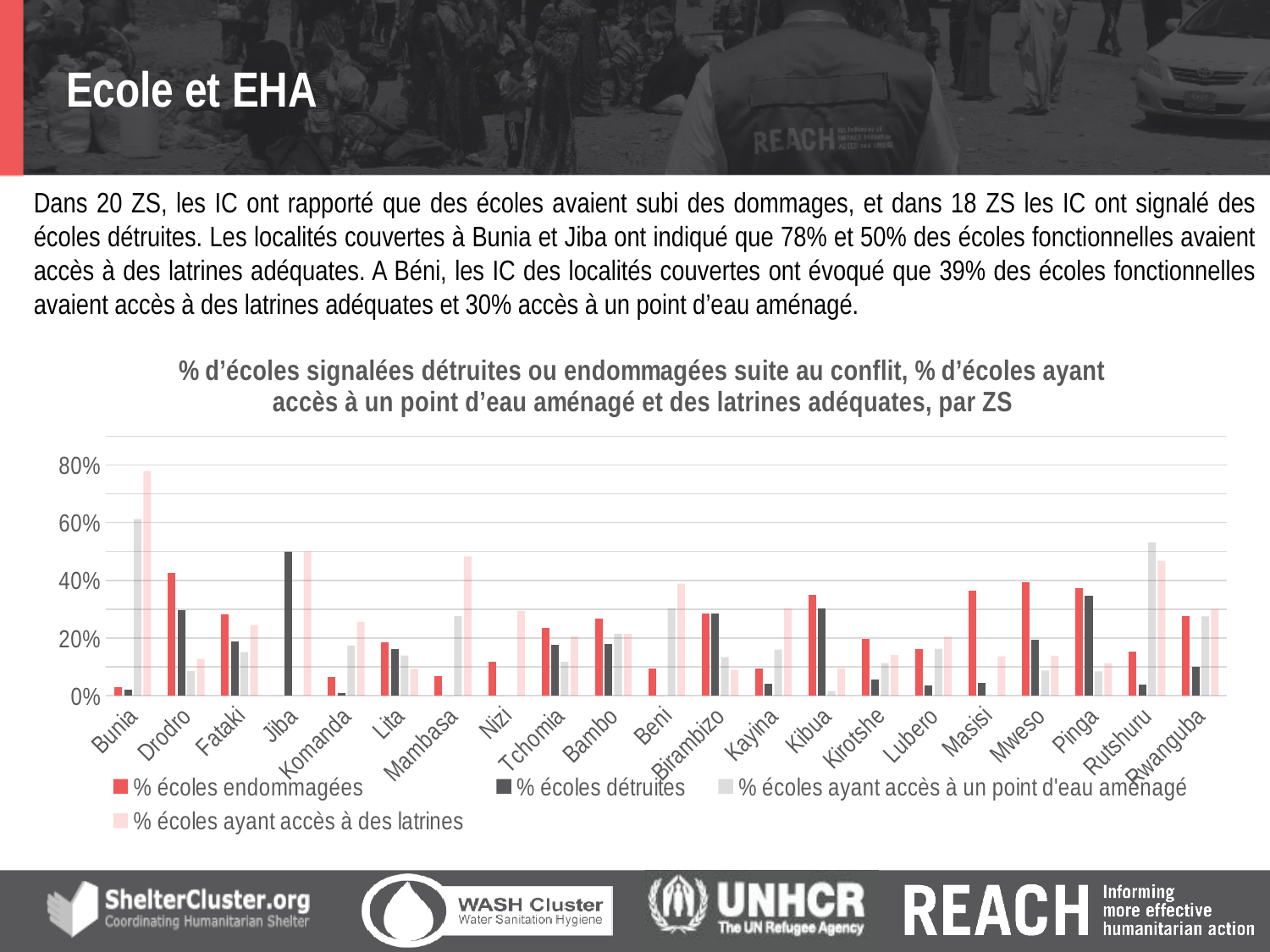
Which ZS has the highest value for % écoles détruites? Jiba Is the value for % écoles détruites in Jiba greater or less than 40%? greater Which ZS has the highest value for % écoles ayant accès à des latrines? Bunia Is the value for % écoles ayant accès à un point d'eau aménagé in Rutshuru greater or less than 40%? greater Which is larger: % écoles endommagées in Kibua or % écoles endommagées in Kayina? Kibua Which ZS has the highest value for % écoles ayant accès à un point d'eau aménagé? Bunia How many series does the chart legend list? 4 Is the value for % écoles ayant accès à des latrines in Bunia greater or less than 60%? greater What kind of chart is shown on the slide? bar chart How many zones de santé (ZS) are shown on the x axis of the chart? 21 Which is larger: % écoles détruites in Jiba or % écoles détruites in Fataki? Jiba